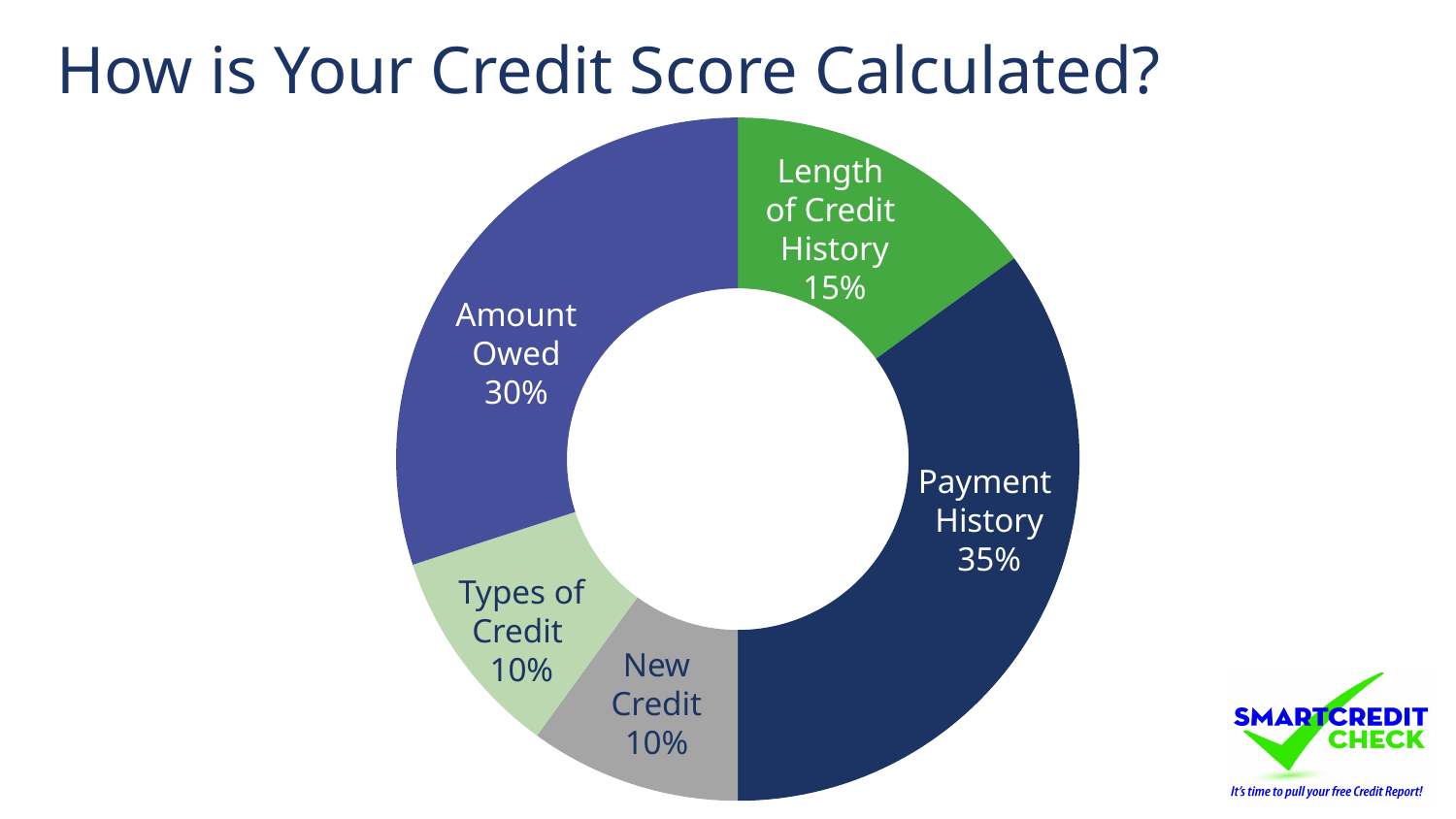
What percentage of the credit score is attributed to New Credit? 10% What is the difference in percentage points between Amount Owed and Length of Credit History? 15 What percentage of the credit score is attributed to Length of Credit History? 15% Which factor has the largest share of the credit score? Payment History What is the combined share of Types of Credit and New Credit? 20% What percentage of the credit score is attributed to Payment History? 35% How many factors are shown in the chart? 5 What percentage of the credit score is attributed to Amount Owed? 30% Which is larger, the share for Length of Credit History or the share for Types of Credit? Length of Credit History What is the difference in percentage points between Payment History and Amount Owed? 5 What kind of chart is shown on the slide? Pie chart (doughnut) What is the title of the slide? How is Your Credit Score Calculated?